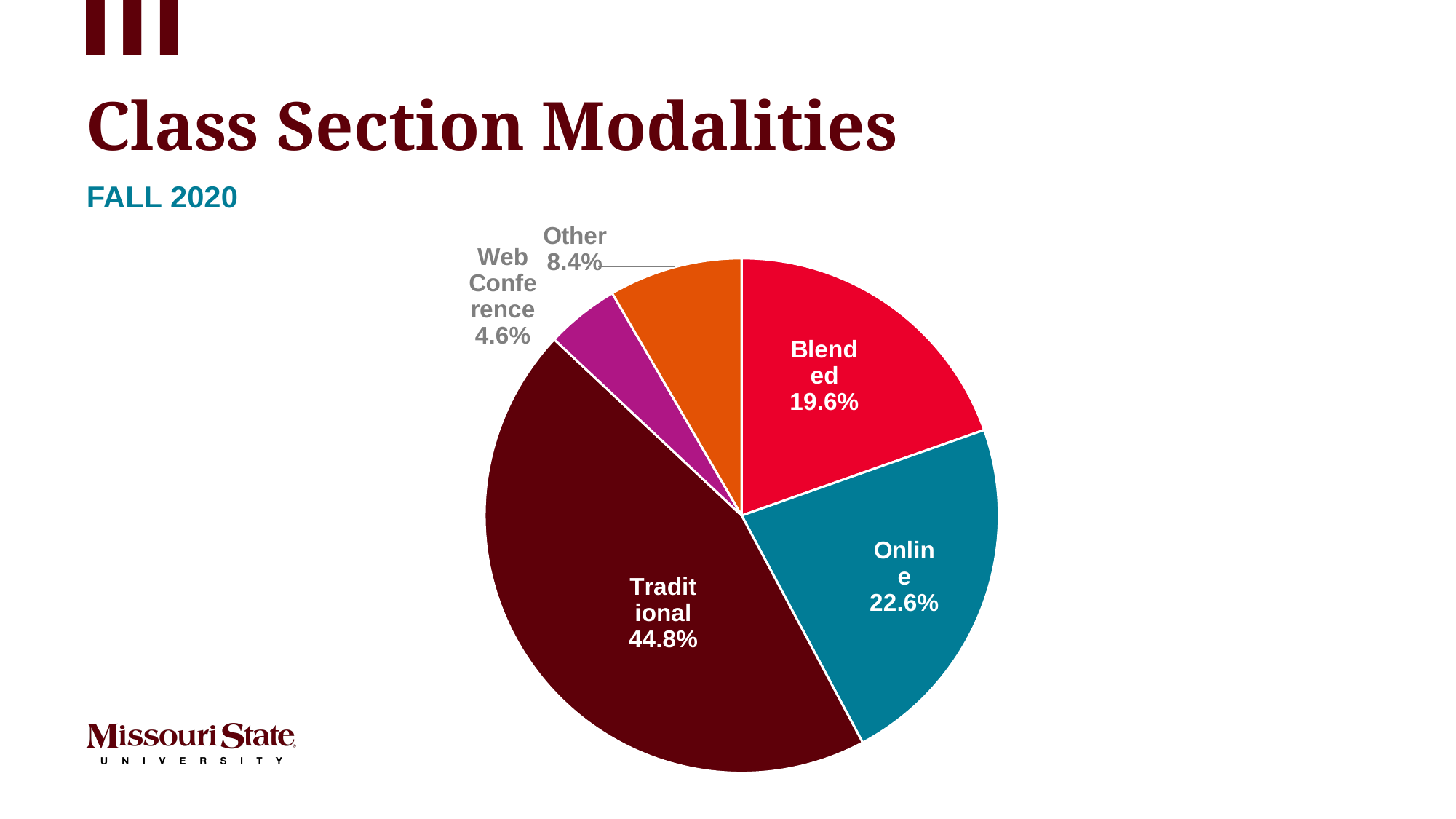
What type of chart is shown on the slide? pie chart What share of class sections is Online? 22.6% What share of class sections is Traditional? 44.8% What share of class sections is Blended? 19.6% How many modalities are shown in the pie chart? 5 Which modality has the largest share of class sections? Traditional Which modality has the smallest share of class sections? Web Conference What semester does the chart cover, according to the subtitle? FALL 2020 What is the difference in percentage points between the Online and Blended shares? 3.0% What share of class sections is Web Conference? 4.6% Which has a larger share, Other or Web Conference? Other What share of class sections is Other? 8.4%